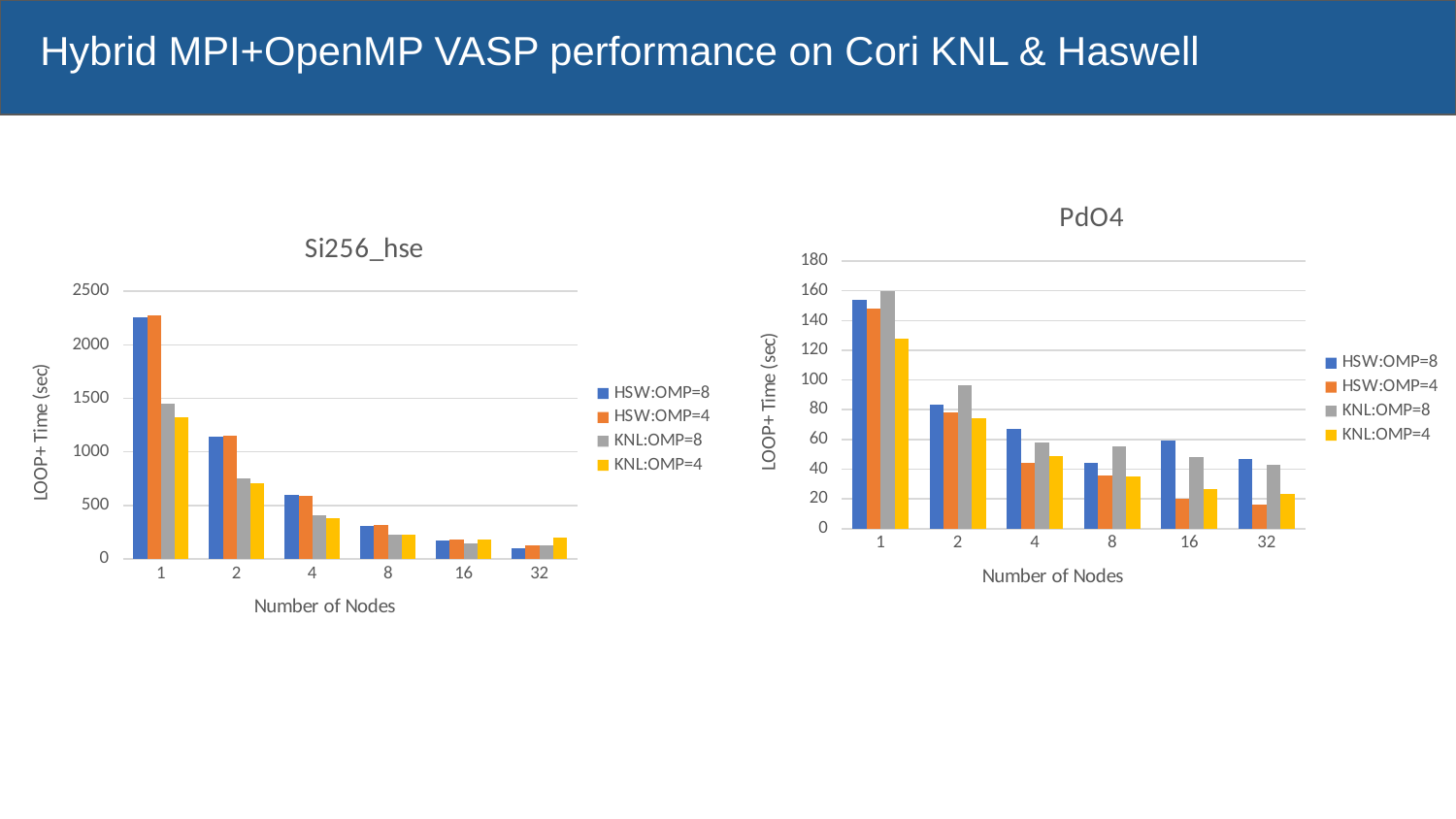
In the PdO4 chart, which series has the lowest value at 16 nodes? HSW:OMP=4 In the PdO4 chart, which series has the highest value at 1 node? KNL:OMP=8 In the Si256_hse chart, is the value for HSW:OMP=8 at 1 node greater or less than 2000? greater What is the y-axis label of the Si256_hse chart? LOOP+ Time (sec) In the Si256_hse chart, which series has the highest value at 32 nodes? KNL:OMP=4 In the Si256_hse chart, is the value for KNL:OMP=8 at 1 node greater or less than 1500? less How many node counts are shown on the x axis of the Si256_hse chart? 6 How many series does the legend of the PdO4 chart list? 4 In the PdO4 chart, is the value for HSW:OMP=4 at 32 nodes greater or less than 20? less What kind of chart is the Si256_hse chart? bar chart